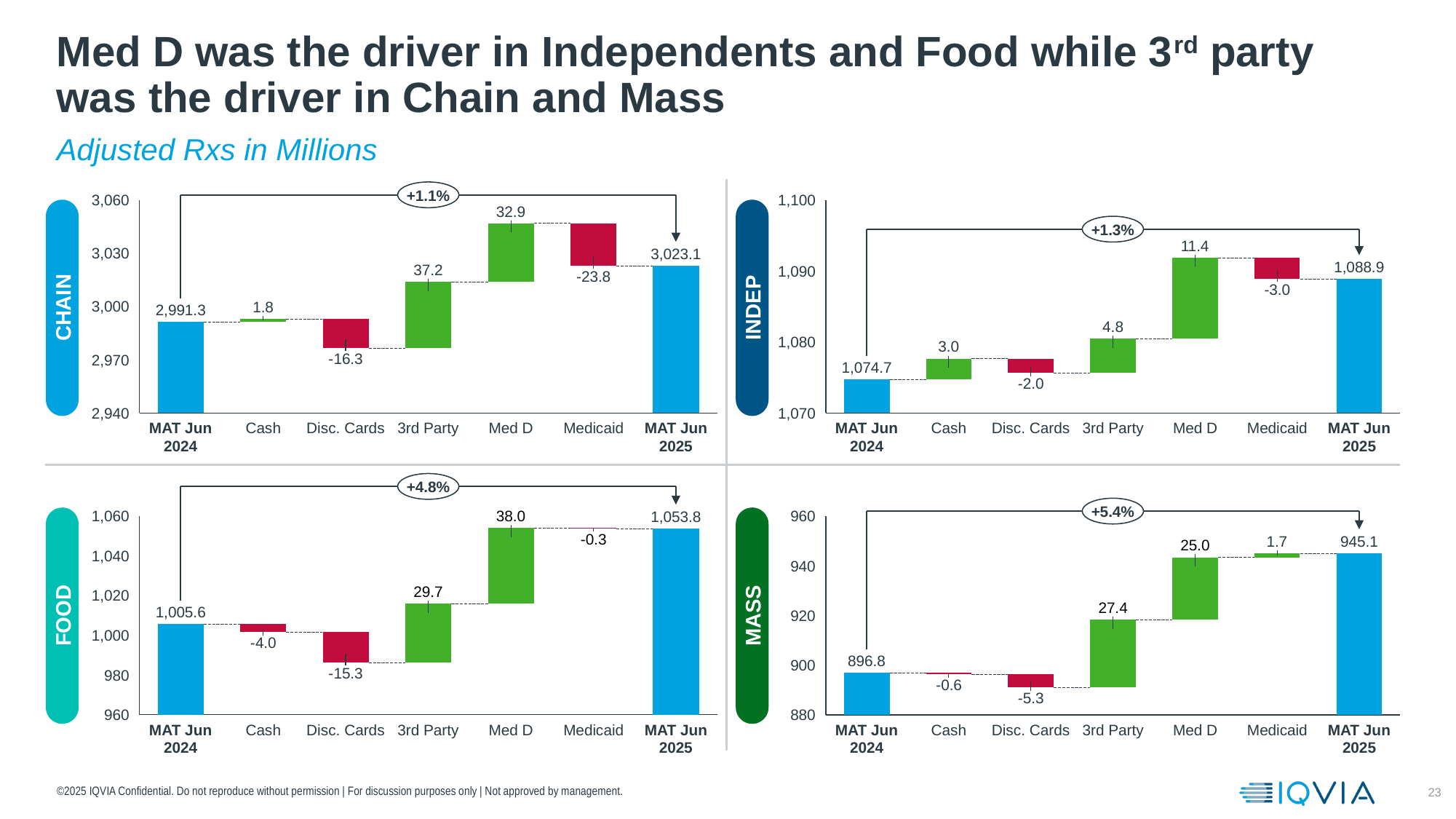
In the FOOD chart, what is the value for MAT Jun 2024? 1,005.6 In the MASS chart, what is the value for 3rd Party? 27.4 In the INDEP chart, what is the value for Med D? 11.4 What type of chart is used for the CHAIN panel? Bar chart (waterfall) In the CHAIN chart, what is the value for MAT Jun 2025? 3,023.1 In the MASS chart, what is the difference between the MAT Jun 2025 and MAT Jun 2024 values? 48.3 In the INDEP chart, which is larger, the value for 3rd Party or the value for Med D? Med D In the CHAIN chart, which of the change categories (Cash, Disc. Cards, 3rd Party, Med D, Medicaid) has the largest positive value? 3rd Party In the CHAIN chart, what is the value for Disc. Cards? -16.3 How many categories are shown on the x axis of the FOOD chart? 7 In the FOOD chart, which of the change categories (Cash, Disc. Cards, 3rd Party, Med D, Medicaid) has the lowest value? Disc. Cards What percentage change is shown in the oval above the MASS chart? +5.4%